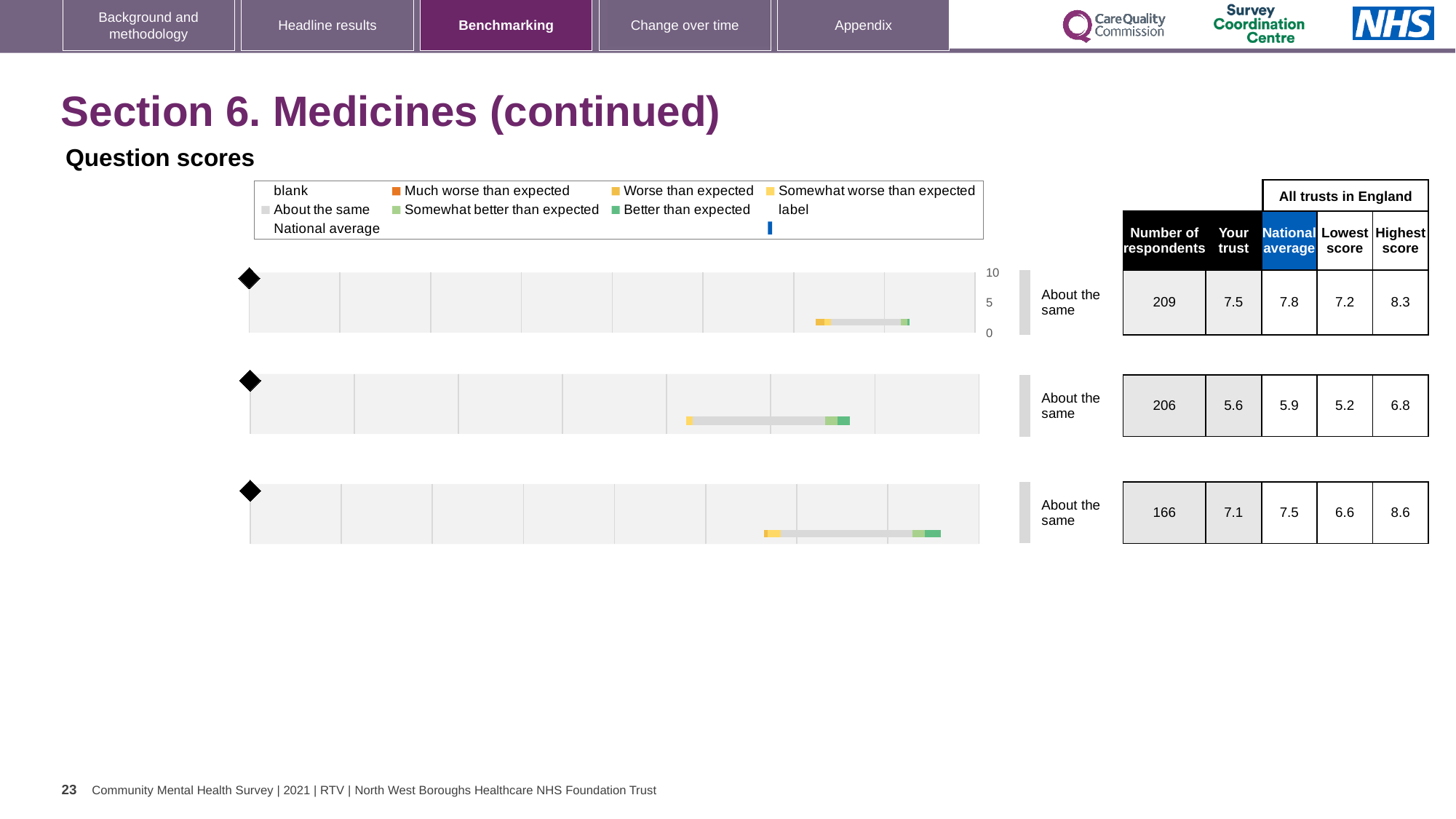
What kind of chart is used to show the question scores? Bar chart In the bottom chart, which is larger: the 'Your trust' score or the national average? National average In the top chart, what is the difference between the national average and the 'Your trust' score? 0.3 In the bottom chart, what is the difference between the highest score and the lowest score? 2.0 Which of the three charts has the lowest 'Your trust' score? The middle chart (5.6) In the middle chart, how many respondents are there? 206 In the bottom chart, what is the highest score among all trusts in England? 8.6 How many question score charts are shown on the slide? 3 In the middle chart, is the 'Your trust' score greater or less than 5? greater In the top chart, what is the 'Your trust' score? 7.5 In the middle chart, what is the lowest score among all trusts in England? 5.2 In the top chart, what is the national average score? 7.8